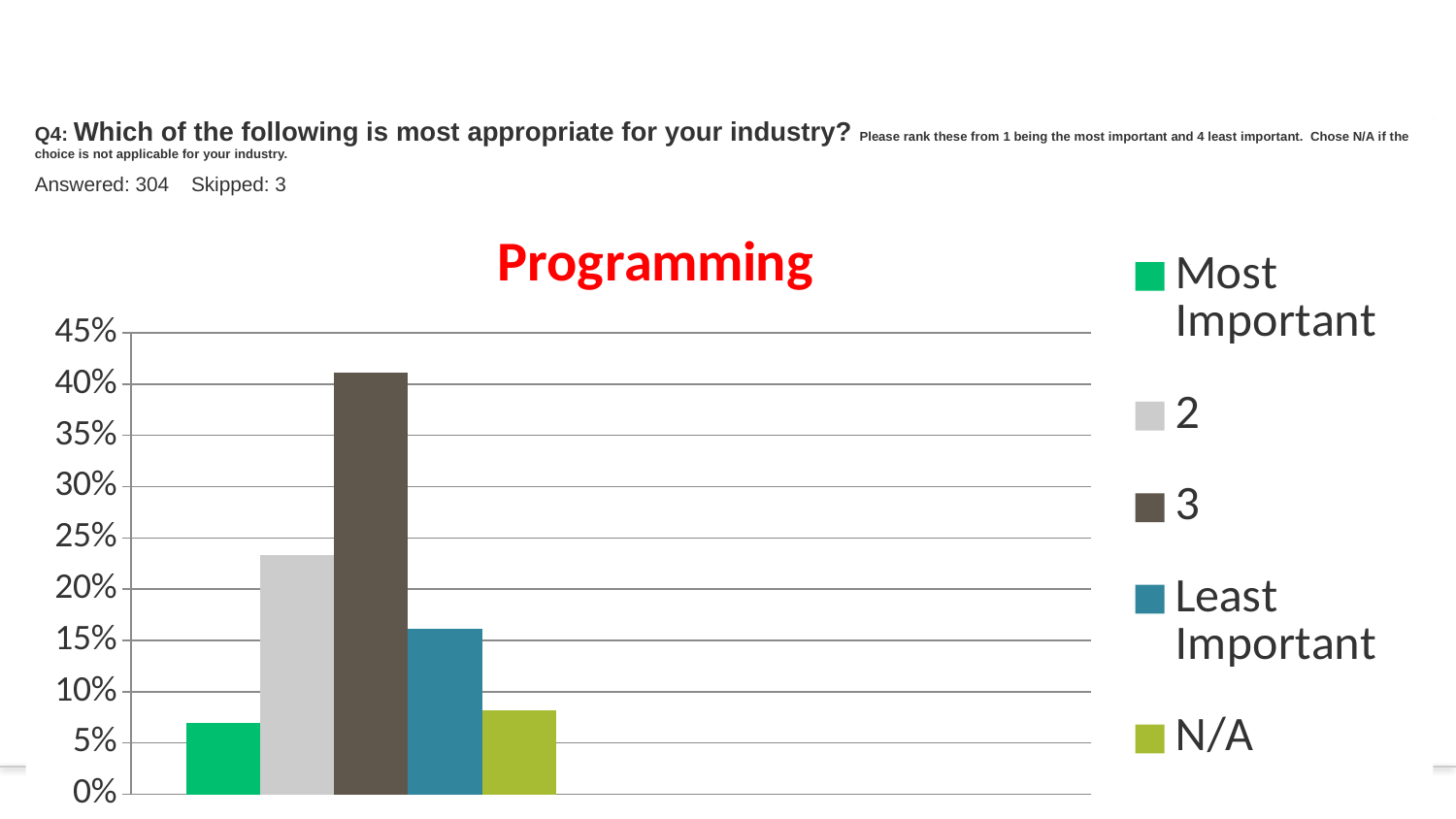
Which is larger, the value for series 2 or the value for Least Important? 2 What kind of chart is shown on the slide? bar chart Is the value for series 3 greater or less than 35%? greater Which is larger, the value for Least Important or the value for Most Important? Least Important Is the value for Most Important greater or less than 10%? less Is the value for N/A greater or less than 10%? less Which series has the highest value in the Programming chart? 3 What is the title of the chart? Programming How many series does the legend list? 5